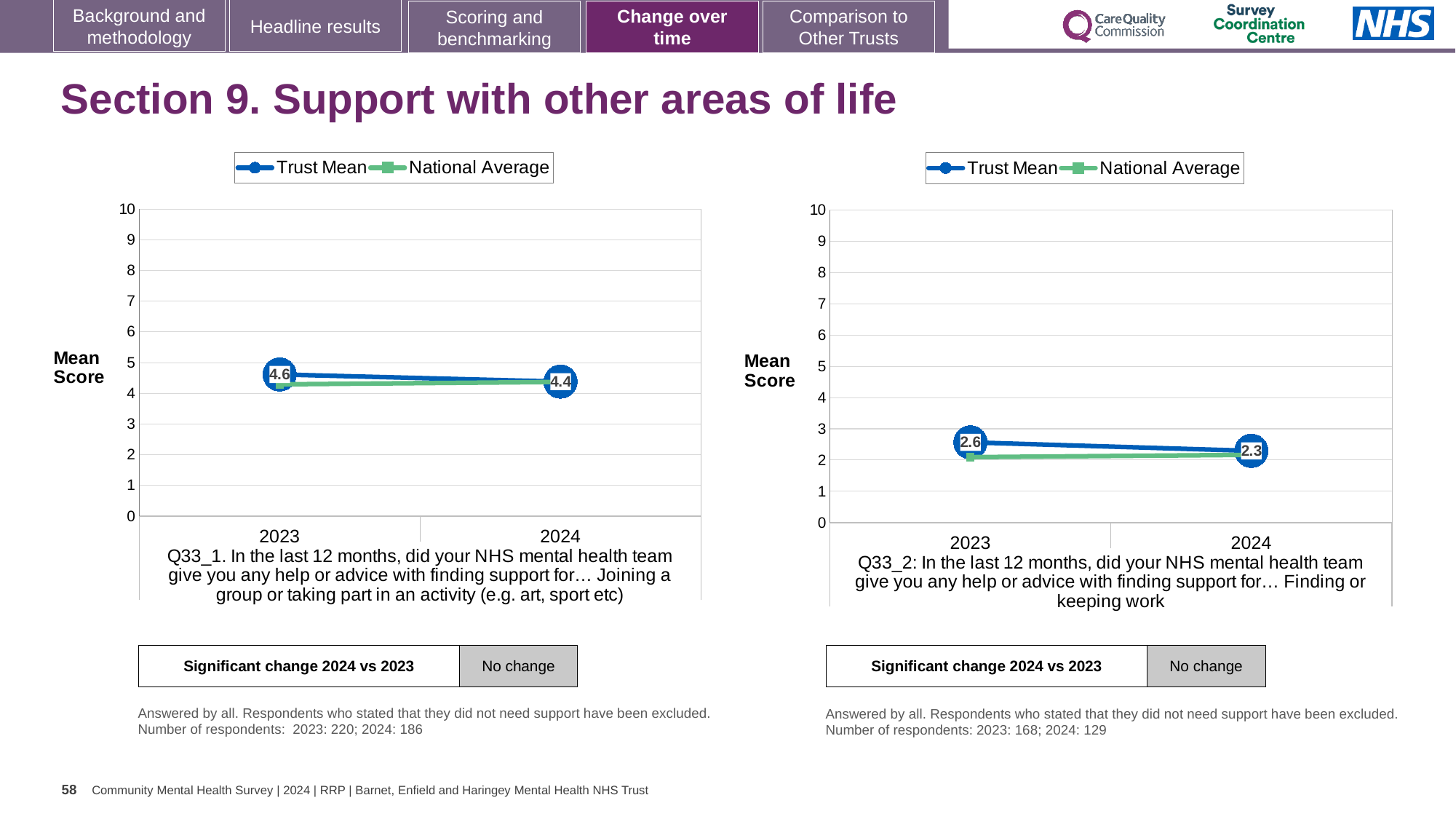
On the right chart (Q33_2), what is the Trust Mean for 2023? 2.6 How many series does the legend of the right chart (Q33_2) list? 2 On the left chart (Q33_1), by how much did the Trust Mean change from 2023 to 2024? 0.2 On the left chart (Q33_1), what is the Trust Mean for 2024? 4.4 How many years are plotted on the x axis of the left chart (Q33_1)? 2 What type of chart is used on the left of the slide (Q33_1)? line chart On the right chart (Q33_2), in 2023 which is larger, the Trust Mean or the National Average? Trust Mean On the left chart (Q33_1), what is the Trust Mean for 2023? 4.6 On the right chart (Q33_2), does the Trust Mean rise or fall from 2023 to 2024? fall On the right chart (Q33_2), what is the difference between the Trust Mean in 2023 and in 2024? 0.3 On the right chart (Q33_2), what is the Trust Mean for 2024? 2.3 On the right chart (Q33_2), is the National Average for 2023 greater or less than 3? less